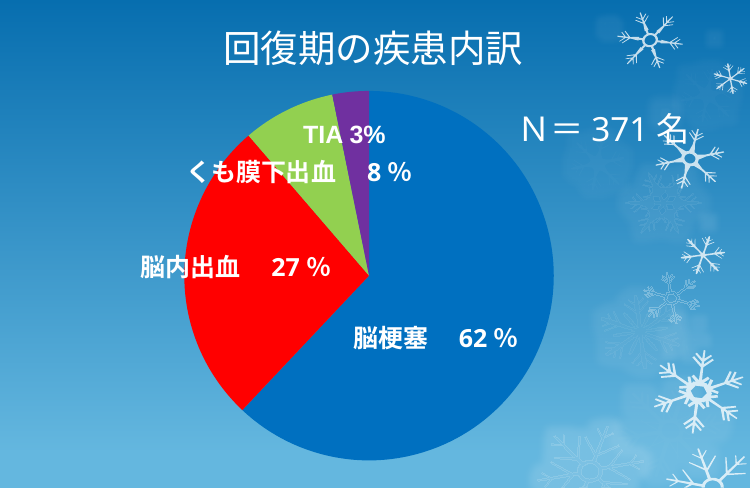
What kind of chart is shown on the slide? pie chart What share of the pie does 脳内出血 account for? 27 % What share of the pie does 脳梗塞 account for? 62 % Which is larger, the share for くも膜下出血 or the share for TIA? くも膜下出血 What share of the pie does くも膜下出血 account for? 8 % Which category has the largest slice of the pie? 脳梗塞 What is the difference in percentage points between 脳梗塞 and 脳内出血? 35 What is the title of the chart? 回復期の疾患内訳 What is the total number of cases (N) stated on the slide? 371 名 How many categories are shown in the pie chart? 4 Which category has the smallest slice of the pie? TIA